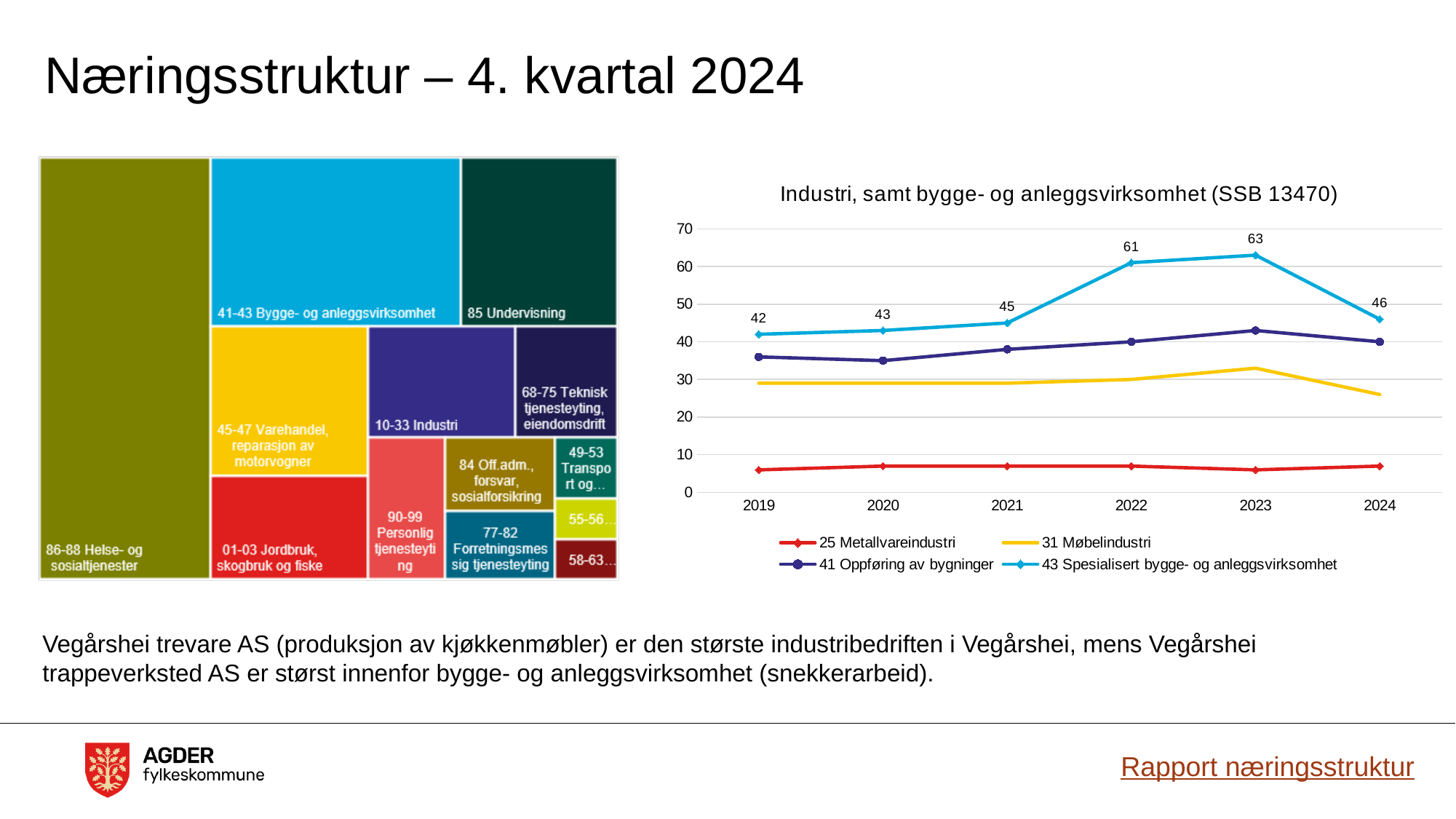
In the line chart on the right, does the value for 43 Spesialisert bygge- og anleggsvirksomhet rise or fall from 2019 to 2023? rise In the line chart 'Industri, samt bygge- og anleggsvirksomhet (SSB 13470)', what is the value for 43 Spesialisert bygge- og anleggsvirksomhet in 2023? 63 How many series does the legend of the line chart on the right list? 4 In the line chart on the right, in which year is 43 Spesialisert bygge- og anleggsvirksomhet highest? 2023 In the line chart on the right, is the value for 43 Spesialisert bygge- og anleggsvirksomhet larger in 2022 or in 2024? 2022 In the line chart on the right, is the value for 31 Møbelindustri in 2024 greater or less than 30? less What kind of chart is the chart on the right of the slide? line chart How many years are shown on the x axis of the line chart on the right? 6 In the line chart on the right, in which year is 43 Spesialisert bygge- og anleggsvirksomhet lowest? 2019 In the line chart on the right, what is the value for 43 Spesialisert bygge- og anleggsvirksomhet in 2019? 42 In the line chart on the right, is the value for 25 Metallvareindustri in 2024 greater or less than 10? less In the line chart on the right, what is the difference between the 2022 and 2021 values for 43 Spesialisert bygge- og anleggsvirksomhet? 16